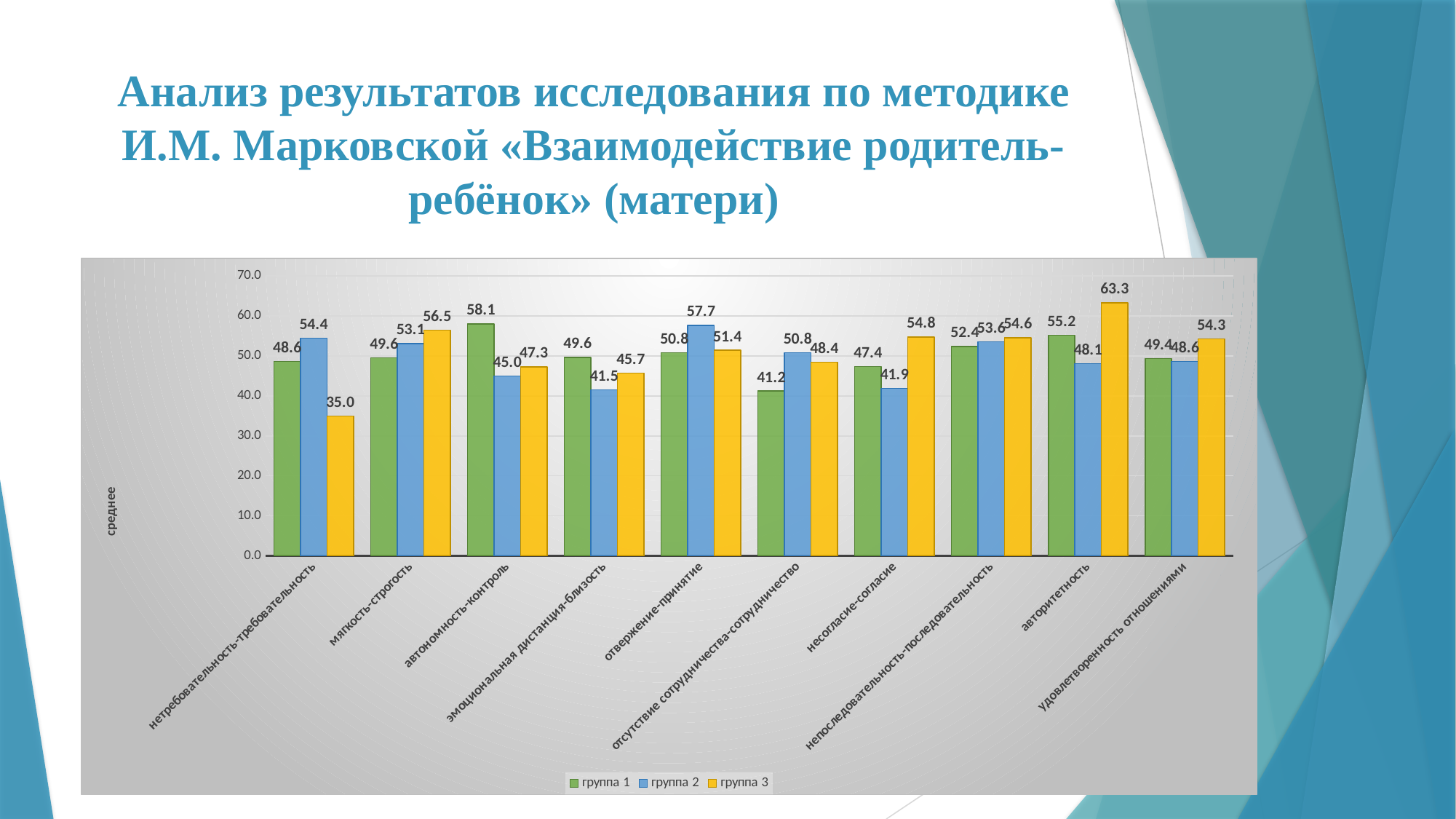
How many series does the legend list? 3 What kind of chart is shown on the slide? bar chart What is the value for группа 1 in the category автономность-контроль? 58.1 What is the value for группа 3 in the category авторитетность? 63.3 In the category несогласие-согласие, which is larger: группа 1 or группа 3? группа 3 What is the difference between группа 2 and группа 3 in the category нетребовательность-требовательность? 19.4 What is the value for группа 2 in the category отвержение-принятие? 57.7 In which category does группа 1 have its lowest value? отсутствие сотрудничества-сотрудничество What is the value for группа 3 in the category нетребовательность-требовательность? 35.0 In which category does группа 3 have its highest value? авторитетность What is the difference between группа 3 and группа 2 in the category авторитетность? 15.2 How many categories are shown on the x axis? 10